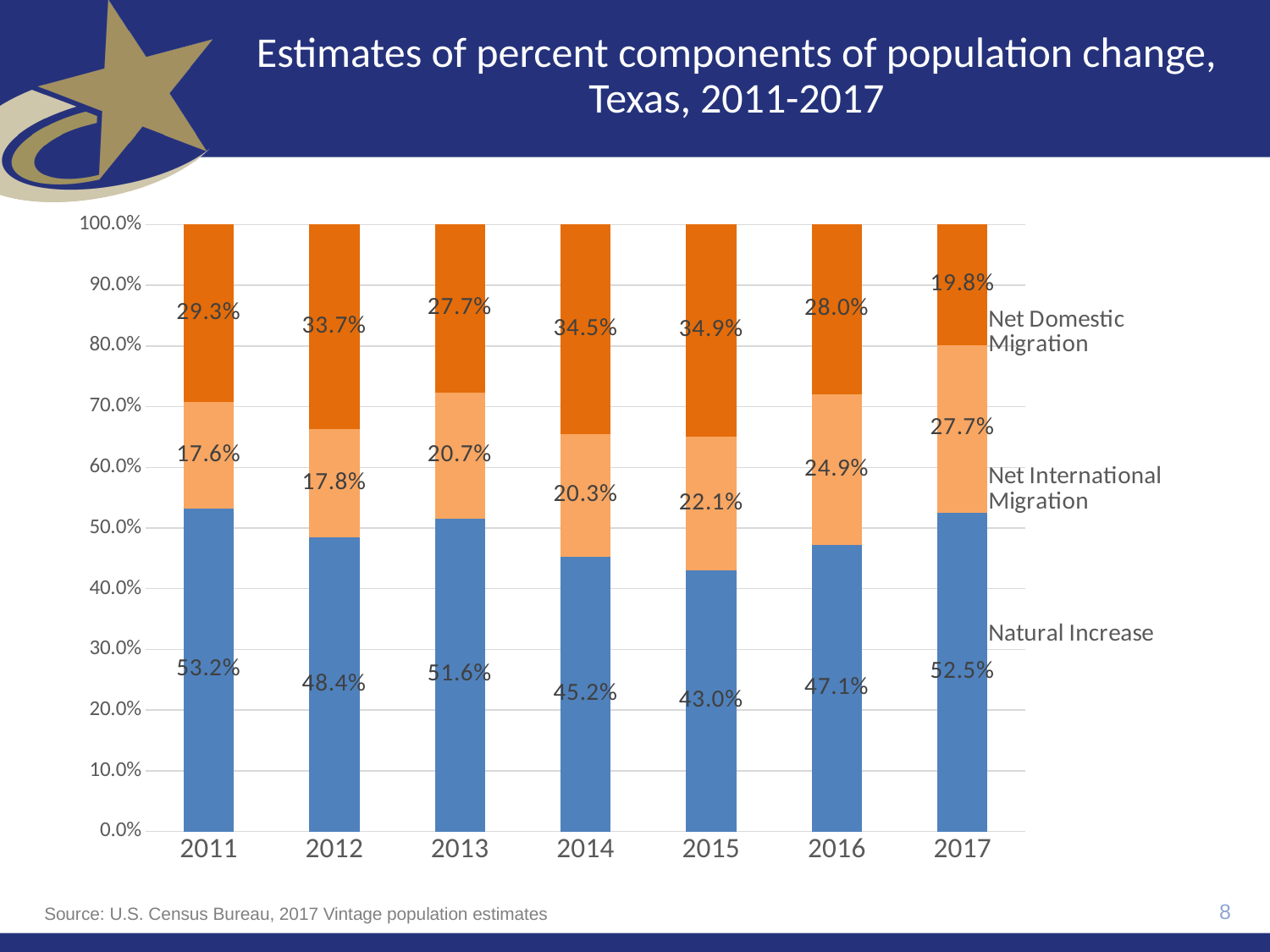
Does Net International Migration rise or fall from 2013 to 2017? Rise Which is larger, Natural Increase in 2012 or Natural Increase in 2016? 2012 In which year is Net International Migration highest? 2017 What is the difference between the Net Domestic Migration values for 2015 and 2017? 15.1% What kind of chart is shown on the slide? Stacked bar chart How many years are shown on the x axis? 7 In which year is Natural Increase highest? 2011 How many series does the chart show? 3 In which year is Net Domestic Migration lowest? 2017 What is the Net International Migration value for 2013? 20.7% What is the Net Domestic Migration value for 2017? 19.8% What is the Natural Increase value for 2015? 43.0%